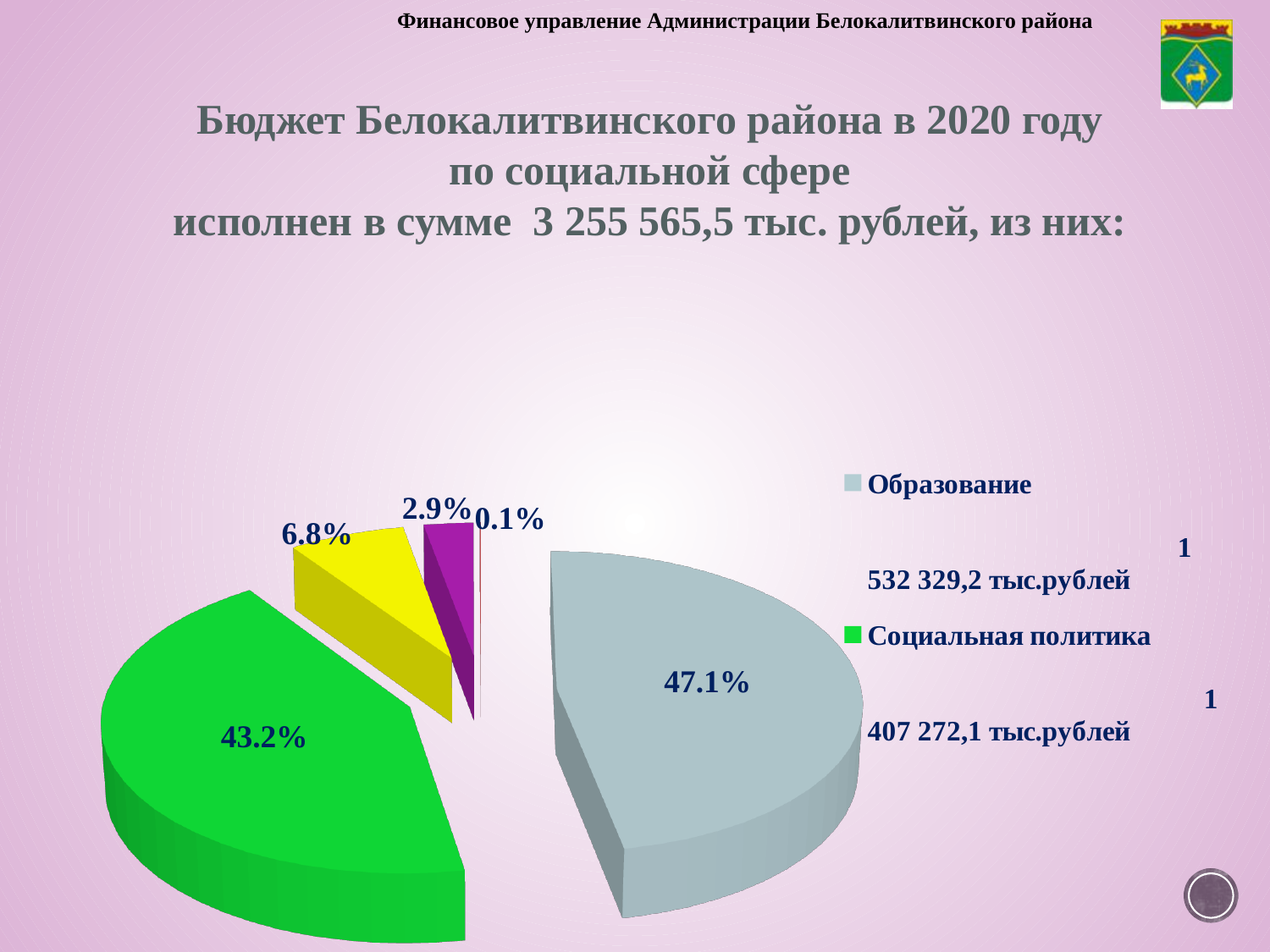
By how many percentage points does the Образование share exceed the Социальная политика share? 3.9 percentage points What percentage is shown on the yellow slice? 6.8% What is the percentage shown on the smallest slice of the pie? 0.1% What amount in тыс.рублей does the legend give for Образование? 1 532 329,2 тыс.рублей What kind of chart is shown on the slide? pie chart How many slices does the pie chart have? 5 Which category has the largest slice of the pie? Образование What share of the pie does Социальная политика account for? 43.2% What colour represents Социальная политика in the legend? green What percentage is shown on the purple slice? 2.9% Which is larger, the share for Образование or the share for Социальная политика? Образование What share of the pie does Образование account for? 47.1%